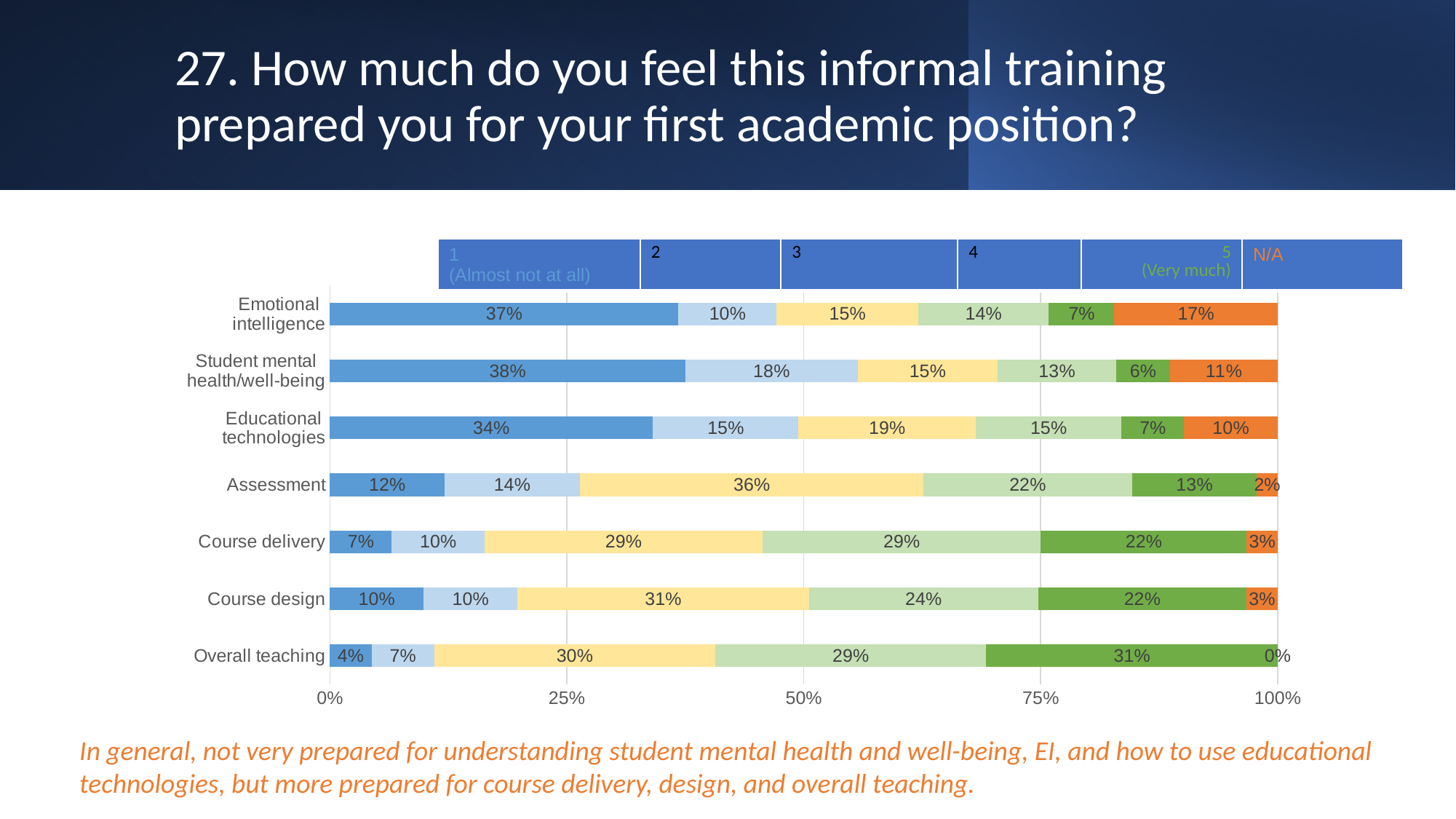
What descriptive label is shown in the legend next to the rating 5? (Very much) Which category has the lowest share of 1 (Almost not at all) ratings? Overall teaching What is the N/A value for Course delivery? 3% What is the value of the 3 rating for Assessment? 36% Which category has the highest share of 5 (Very much) ratings? Overall teaching What is the difference in percentage points between the N/A value for Emotional intelligence and the N/A value for Student mental health/well-being? 6 What percentage of respondents rated Overall teaching as 5 (Very much)? 31% How many categories are shown on the y axis of the chart? 7 What kind of chart is shown on the slide? Stacked bar chart What percentage of respondents rated Emotional intelligence as 1 (Almost not at all)? 37% How many series does the legend list? 6 Which has a larger 4 rating share, Course delivery or Course design? Course delivery